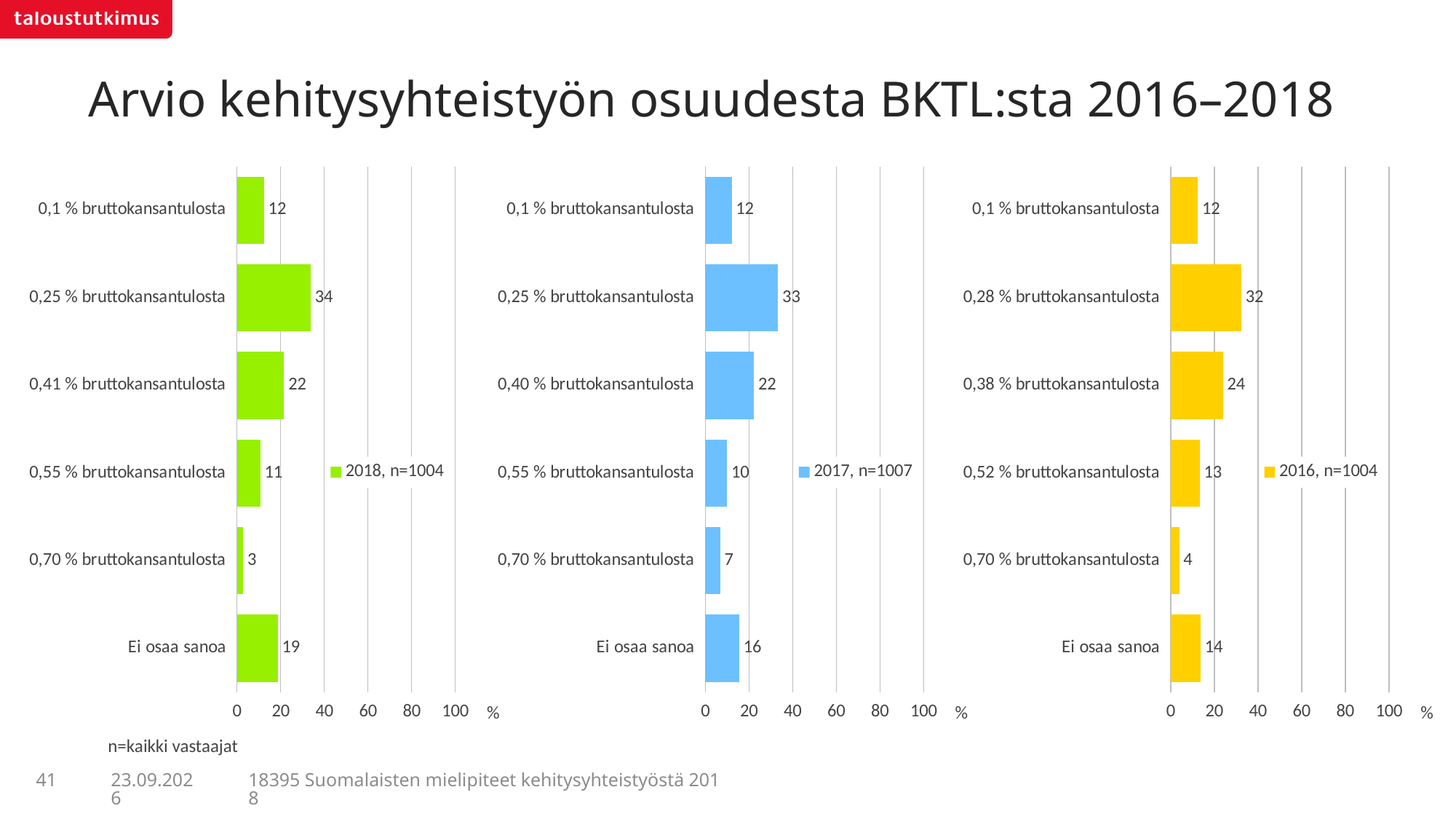
In the left chart (2018, n=1004), which category has the lowest value? 0,70 % bruttokansantulosta In the right chart (2016, n=1004), what is the value for "0,38 % bruttokansantulosta"? 24 How many categories does the right chart (2016, n=1004) show? 6 In the middle chart (2017, n=1007), which category has the highest value? 0,25 % bruttokansantulosta In the left chart (2018, n=1004), what is the value for "0,25 % bruttokansantulosta"? 34 In the middle chart (2017, n=1007), is the value for "0,25 % bruttokansantulosta" greater or less than 20? greater How many series does the legend of the middle chart list? 1 What is the legend entry of the right chart? 2016, n=1004 In the left chart (2018, n=1004), which is larger: the value for "0,1 % bruttokansantulosta" or the value for "Ei osaa sanoa"? Ei osaa sanoa What kind of chart is the left chart (2018, n=1004)? bar chart In the middle chart (2017, n=1007), what is the value for "Ei osaa sanoa"? 16 In the right chart (2016, n=1004), what is the difference between the values for "0,28 % bruttokansantulosta" and "0,38 % bruttokansantulosta"? 8